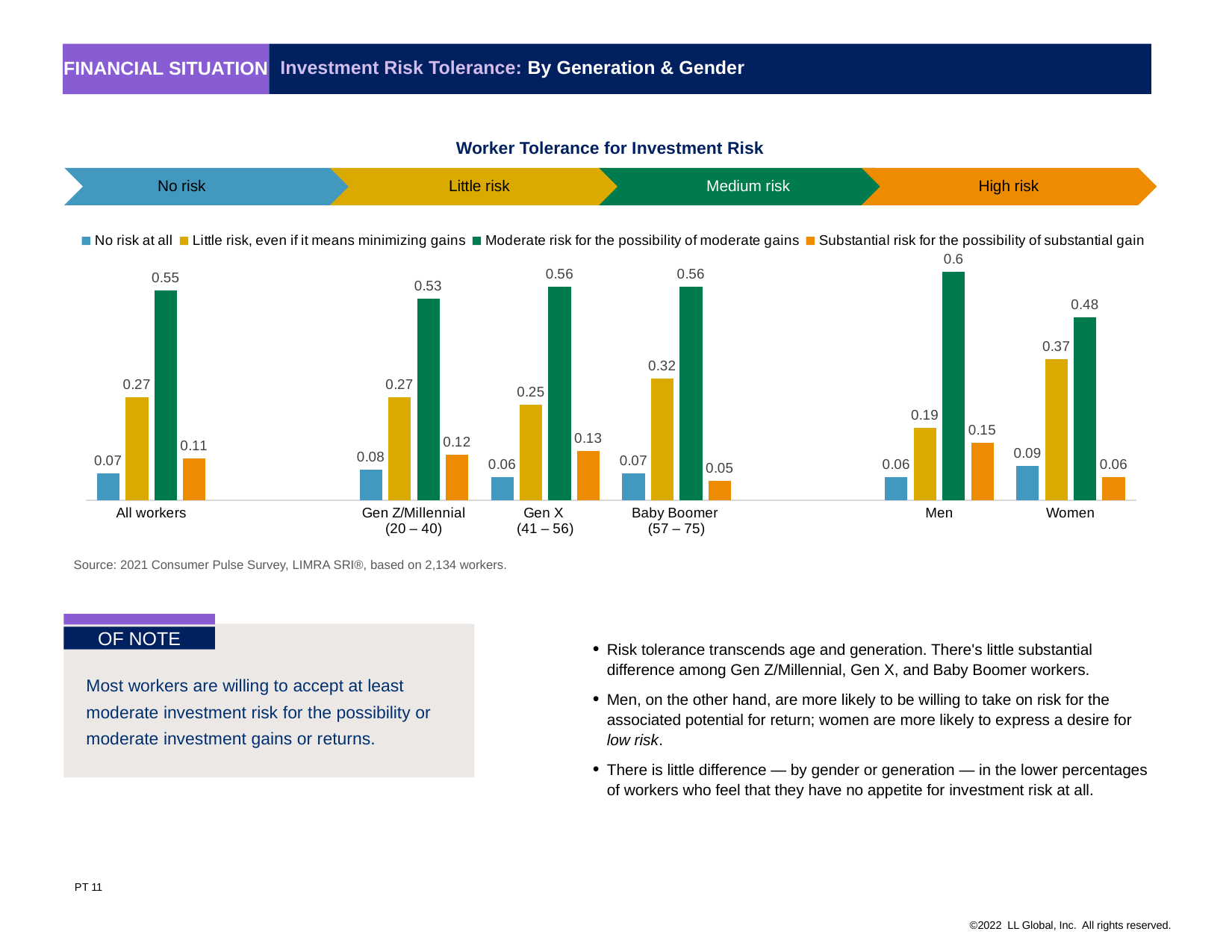
What is the value for 'Moderate risk for the possibility of moderate gains' among All workers? 0.55 What kind of chart is shown on the slide? Bar chart Which category has the lowest value for 'Substantial risk for the possibility of substantial gain'? Baby Boomer (57 – 75) How many categories are shown on the x axis of the chart? 6 What is the value for 'No risk at all' among Baby Boomer (57 – 75) workers? 0.07 Which category has the highest value for 'Moderate risk for the possibility of moderate gains'? Men How many series does the chart legend list? 4 What is the difference between the 'Little risk, even if it means minimizing gains' values for Women and Men? 0.18 What is the title of the chart? Worker Tolerance for Investment Risk Which is larger: the 'Substantial risk for the possibility of substantial gain' value for Gen X (41 – 56) or for Baby Boomer (57 – 75)? Gen X (41 – 56) What is the value for 'Substantial risk for the possibility of substantial gain' among Men? 0.15 What is the value for 'Little risk, even if it means minimizing gains' among Women? 0.37